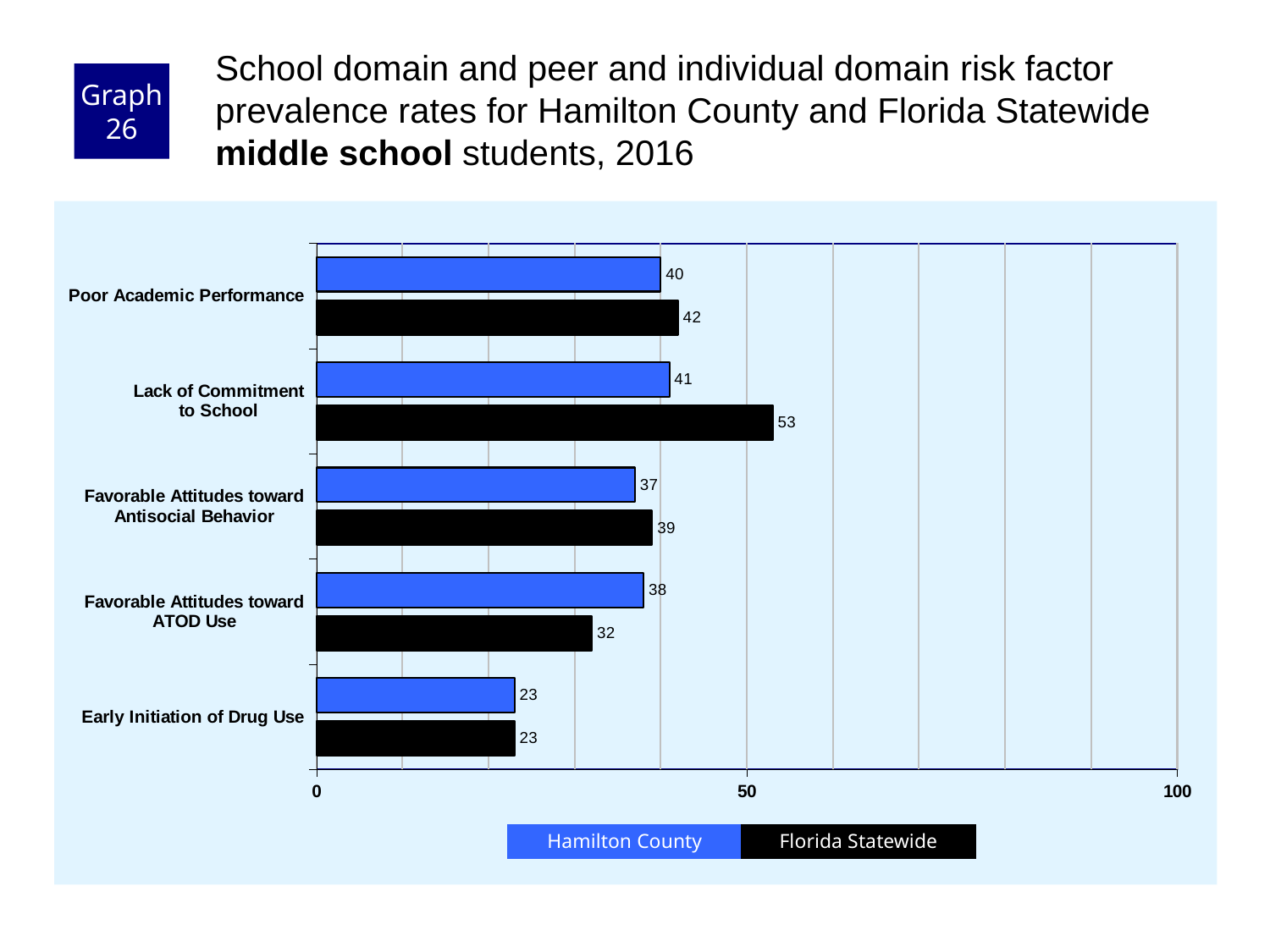
For Favorable Attitudes toward ATOD Use, which is larger: Hamilton County or Florida Statewide? Hamilton County How many risk factor categories are shown on the chart? 5 What kind of chart is shown on the slide? bar chart Which colour represents Florida Statewide in the chart? black Which risk factor has the highest Florida Statewide value? Lack of Commitment to School What is the Hamilton County value for Favorable Attitudes toward ATOD Use? 38 What is the Florida Statewide value for Lack of Commitment to School? 53 Is the Florida Statewide value for Lack of Commitment to School greater or less than 50? greater How many series does the legend list? 2 What is the difference between the Florida Statewide and Hamilton County values for Lack of Commitment to School? 12 Which risk factor has the lowest Hamilton County value? Early Initiation of Drug Use What is the Hamilton County value for Poor Academic Performance? 40